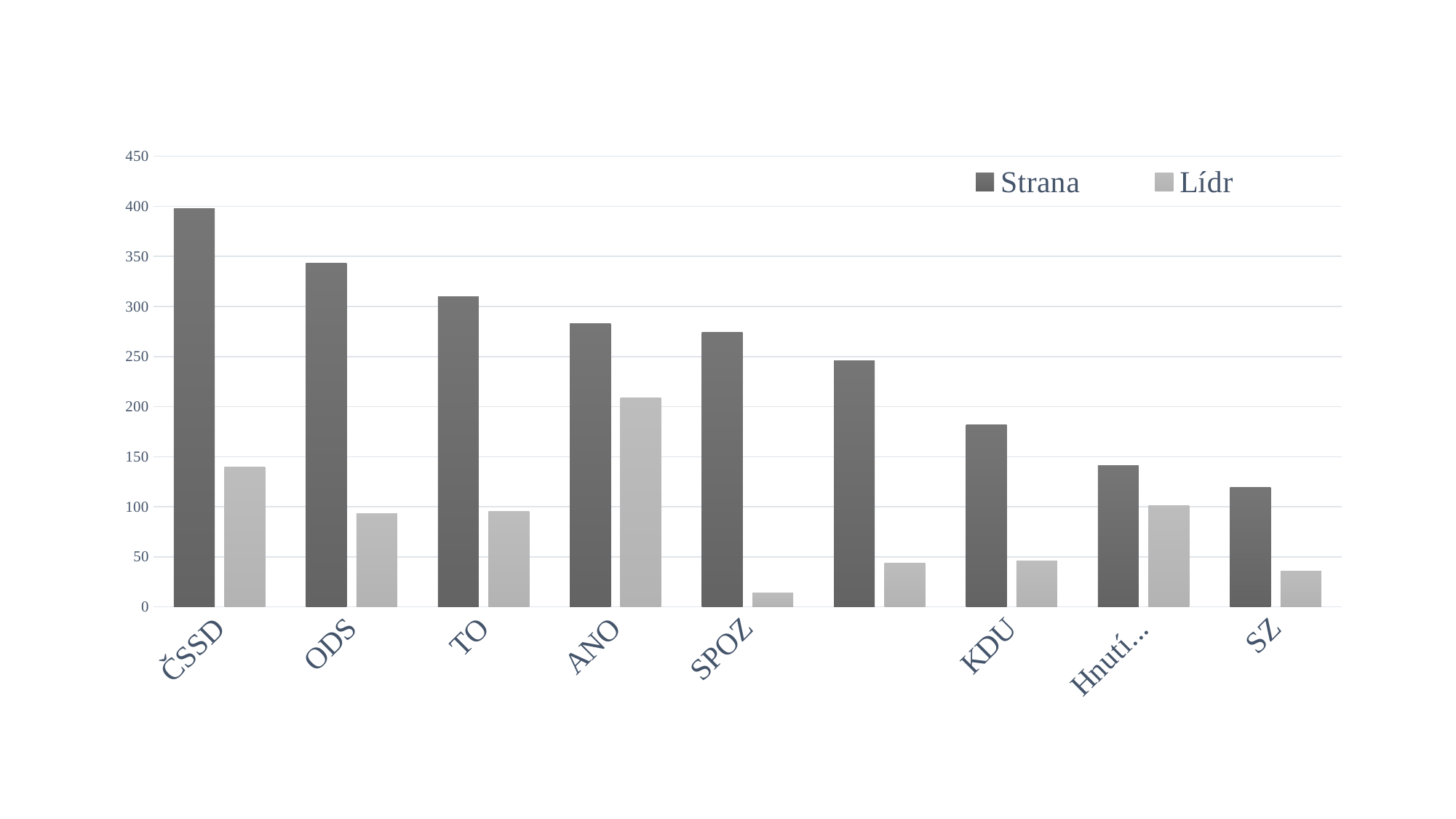
How many series does the legend list? 2 Which is larger, the Lídr value for ANO or the Lídr value for ODS? ANO Do the Strana values rise or fall moving from left to right across the categories? fall Is the Lídr value for SPOZ greater or less than 50? less What kind of chart is shown on the slide? bar chart Which category has the lowest Strana value? SZ Is the Strana value for ČSSD greater or less than 350? greater Which category has the lowest Lídr value? SPOZ Which category has the highest Lídr value? ANO Which category has the highest Strana value? ČSSD How many category groups of bars are plotted on the chart? 9 What are the two series named in the legend? Strana and Lídr